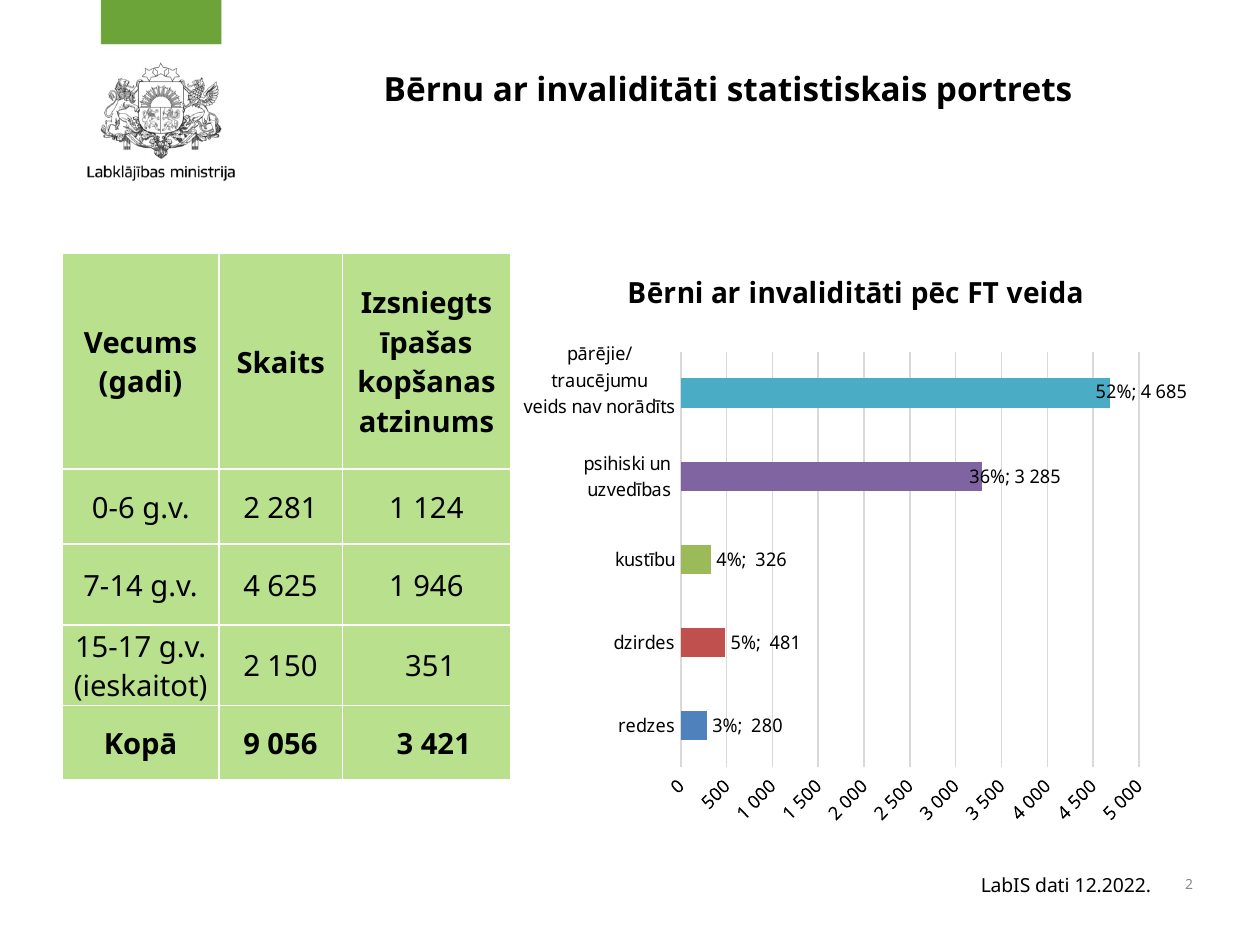
How many categories are shown in the chart? 5 What percentage is shown for the 'kustību' category? 4% Is the value for 'psihiski un uzvedības' greater or less than 3 000? greater What percentage is shown for the 'pārējie/ traucējumu veids nav norādīts' category? 52% What is the difference in the number of children between 'dzirdes' and 'kustību'? 155 Which category has the lowest value in the chart? redzes What is the number of children shown for the 'dzirdes' category? 481 Which category has the highest value in the chart? pārējie/ traucējumu veids nav norādīts What is the number of children shown for the 'psihiski un uzvedības' category? 3 285 What is the difference in the number of children between 'pārējie/ traucējumu veids nav norādīts' and 'psihiski un uzvedības'? 1 400 Which category has a larger value, 'dzirdes' or 'redzes'? dzirdes What type of chart is shown on the slide? bar chart